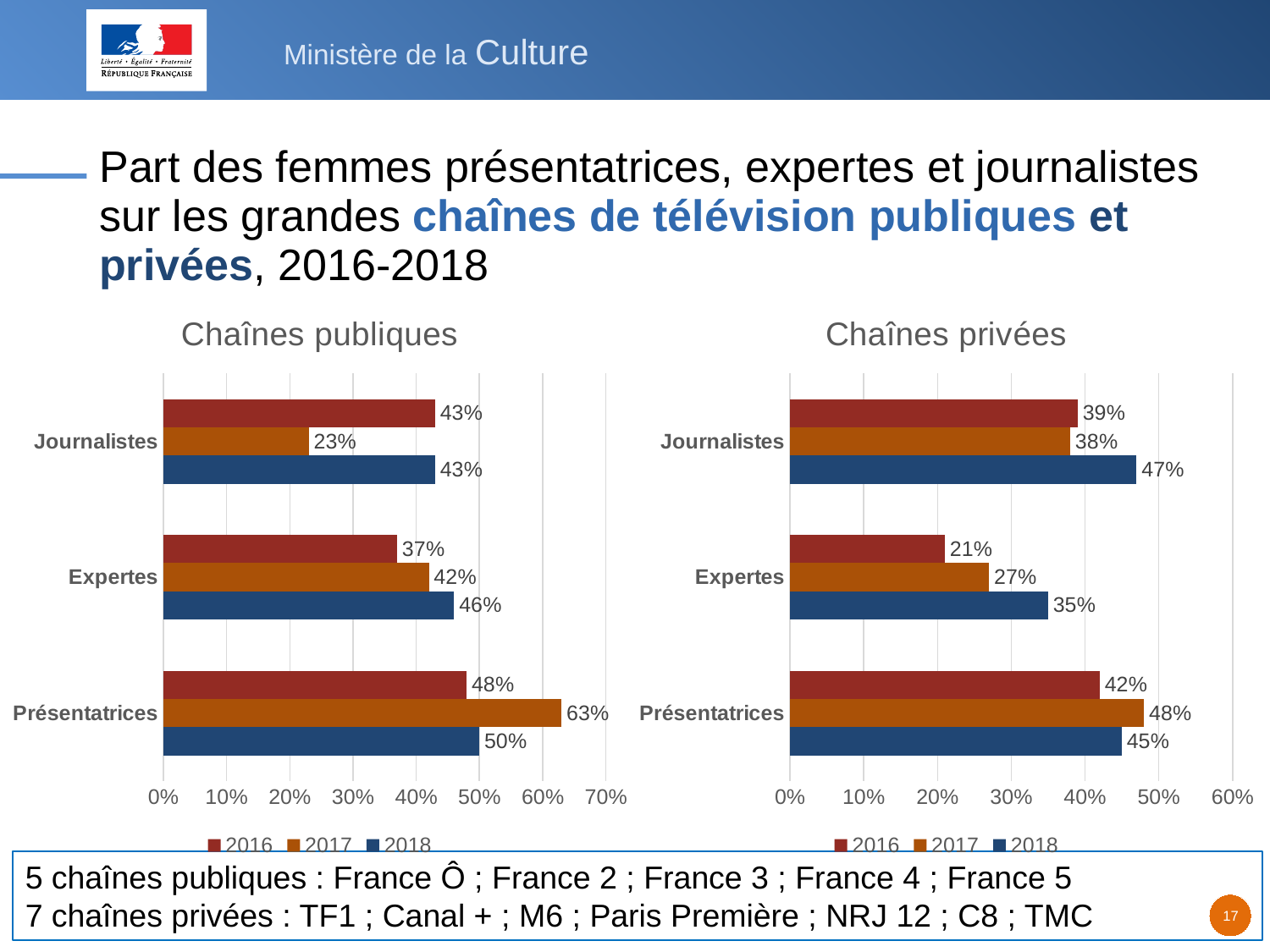
In the 'Chaînes privées' chart, what is the difference between the 2018 and 2016 values for Expertes? 14% In the 'Chaînes privées' chart, do the values for Expertes rise or fall from 2016 to 2018? Rise In the 'Chaînes publiques' chart, what is the value for Journalistes in 2017? 23% In the 'Chaînes publiques' chart, which category has the highest value in 2017? Présentatrices What type of chart is the 'Chaînes publiques' chart? Bar chart In the 'Chaînes publiques' chart, what is the difference between the 2017 and 2016 values for Présentatrices? 15% In the 'Chaînes privées' chart, which category has the lowest value in 2016? Expertes In the 'Chaînes privées' chart, how many series does the legend list? 3 In the 'Chaînes privées' chart, what is the value for Expertes in 2018? 35% In the 'Chaînes publiques' chart, how many categories are shown on the vertical axis? 3 In the 'Chaînes privées' chart, which is larger for Présentatrices: the 2017 value or the 2018 value? 2017 What is the title of the chart on the right side of the slide? Chaînes privées